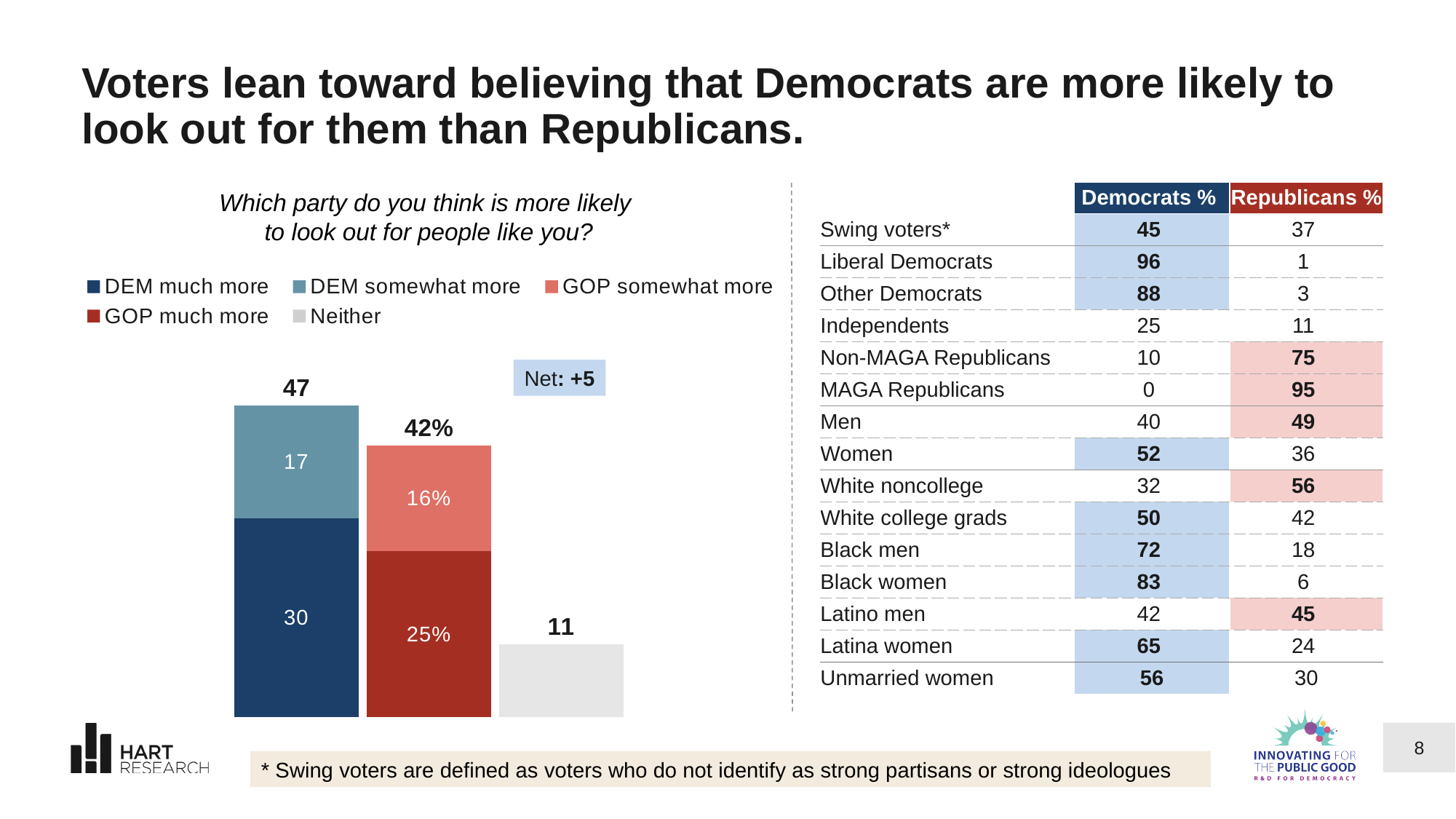
What is the value shown for Neither? 11 How many series does the chart legend list? 5 What is the total of the GOP stacked bar? 42% What is the total of the Democrats stacked bar? 47 What is the value of the DEM somewhat more segment? 17 What is the value of the GOP much more segment? 25% What is the value of the GOP somewhat more segment? 16% What type of chart is shown on the left of the slide? stacked bar chart What is the value of the DEM much more segment? 30 What is the difference between the Democrats bar total (47) and the GOP bar total (42)? 5 Which is larger, the DEM much more segment or the GOP much more segment? DEM much more What net value is shown in the box on the chart? +5